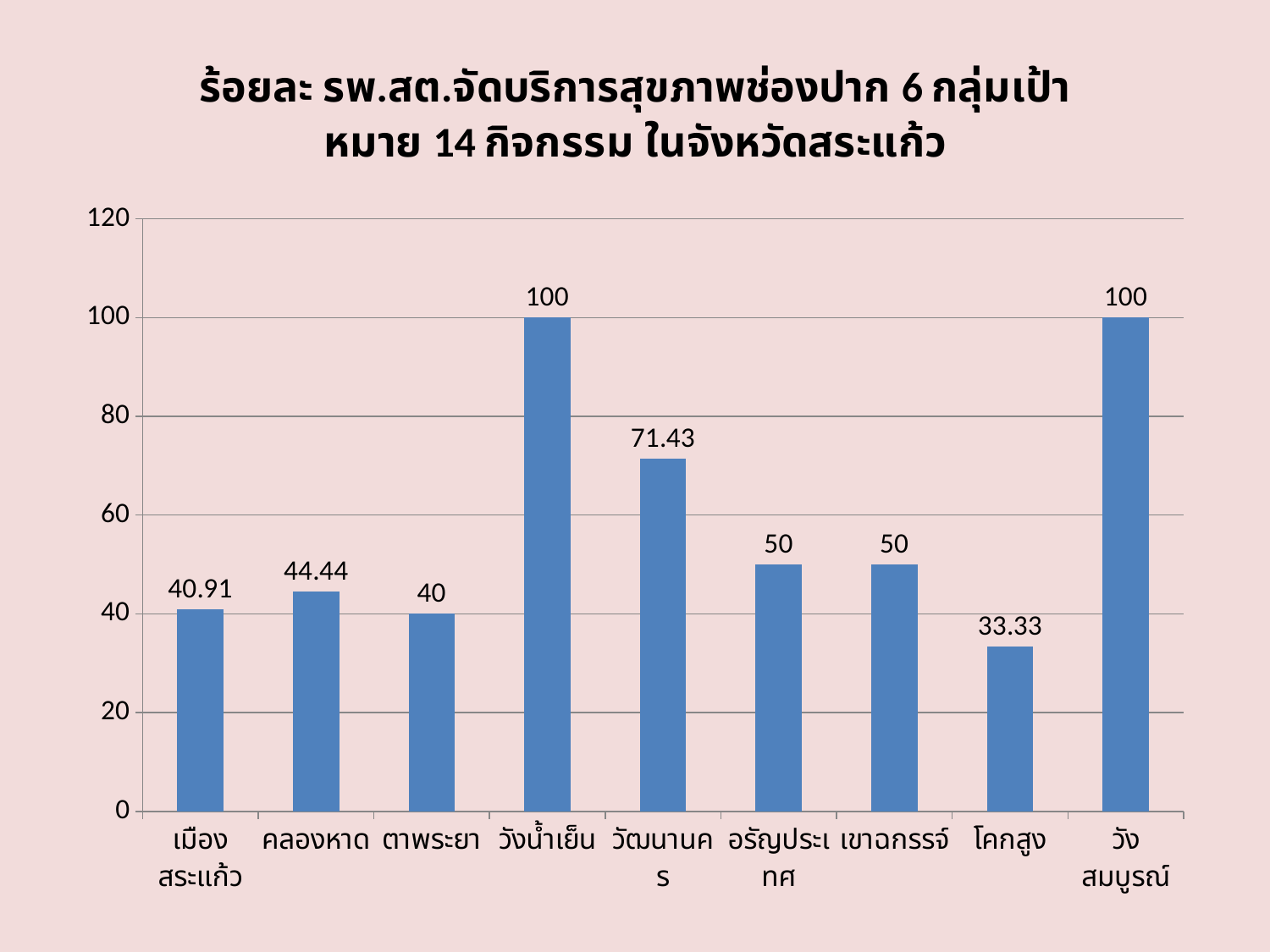
What is the value for คลองหาด? 44.44 What kind of chart is shown on the slide? bar chart How many categories are shown on the x axis? 9 What is the value for วัฒนานคร? 71.43 What is the value for เขาฉกรรจ์? 50 Which is larger, the value for เมืองสระแก้ว or the value for โคกสูง? เมืองสระแก้ว Is the value for วัฒนานคร greater or less than 60? greater Which category has the lowest value? โคกสูง What is the difference between the values for วัฒนานคร and อรัญประเทศ? 21.43 What is the difference between the values for คลองหาด and ตาพระยา? 4.44 Which two categories share the highest value of 100? วังน้ำเย็น and วังสมบูรณ์ What is the value for เมืองสระแก้ว? 40.91